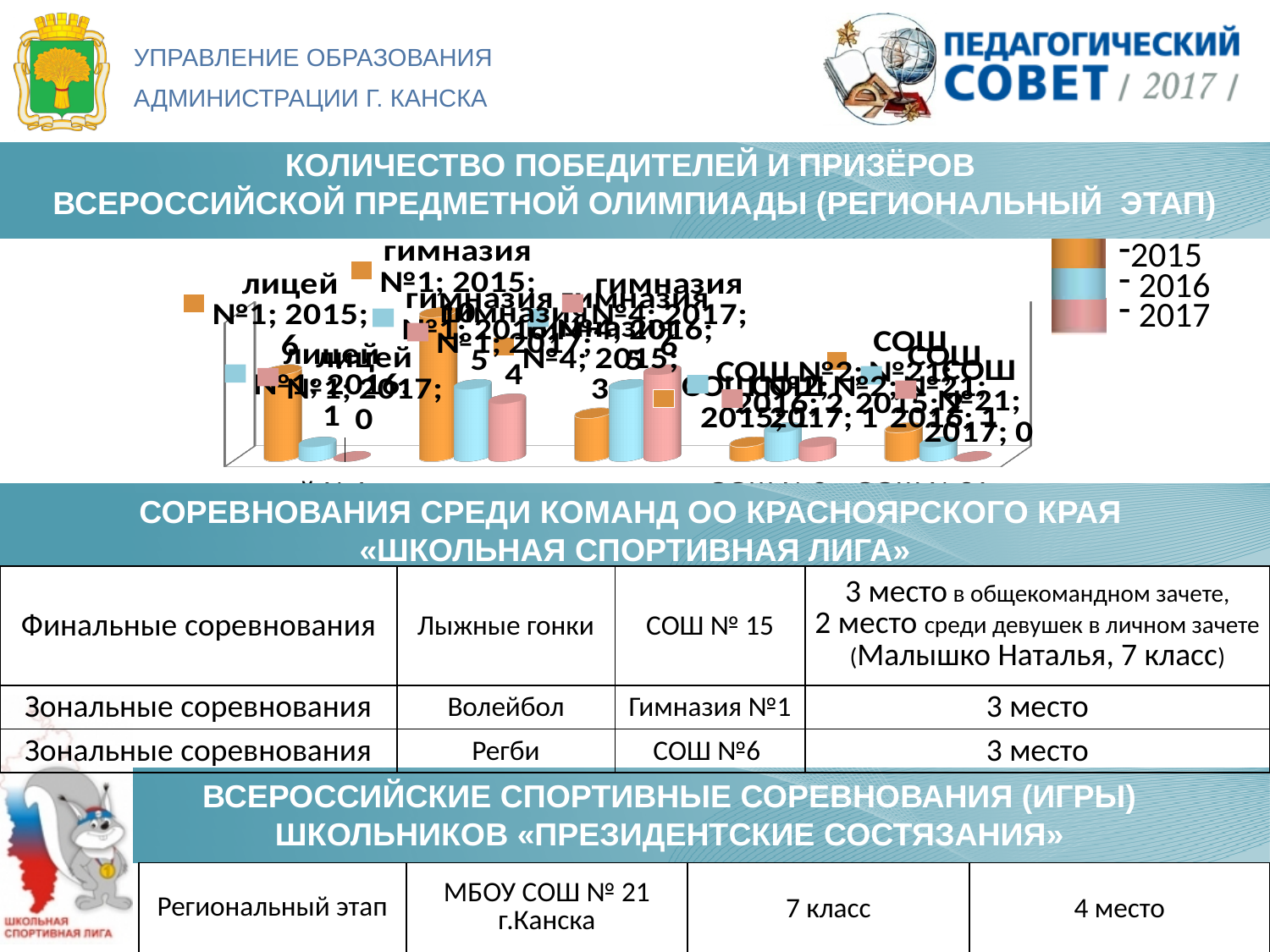
What is the value for гимназия №1 in 2015? 10 What is the value for лицей №1 in 2015? 6 How many schools (category groups) are plotted on the chart? 5 What is the value for СОШ №21 in 2017? 0 What is the title of the chart? КОЛИЧЕСТВО ПОБЕДИТЕЛЕЙ И ПРИЗЁРОВ ВСЕРОССИЙСКОЙ ПРЕДМЕТНОЙ ОЛИМПИАДЫ (РЕГИОНАЛЬНЫЙ ЭТАП) Which is larger in 2015: the value for лицей №1 or for гимназия №1? гимназия №1 What kind of chart is shown on the slide? bar chart Which school has the highest value in the 2015 series? гимназия №1 What is the difference between the 2015 values for лицей №1 and гимназия №1? 4 What is the value for лицей №1 in 2017? 0 Which years are listed in the chart legend? 2015, 2016, 2017 How many series does the chart legend list? 3